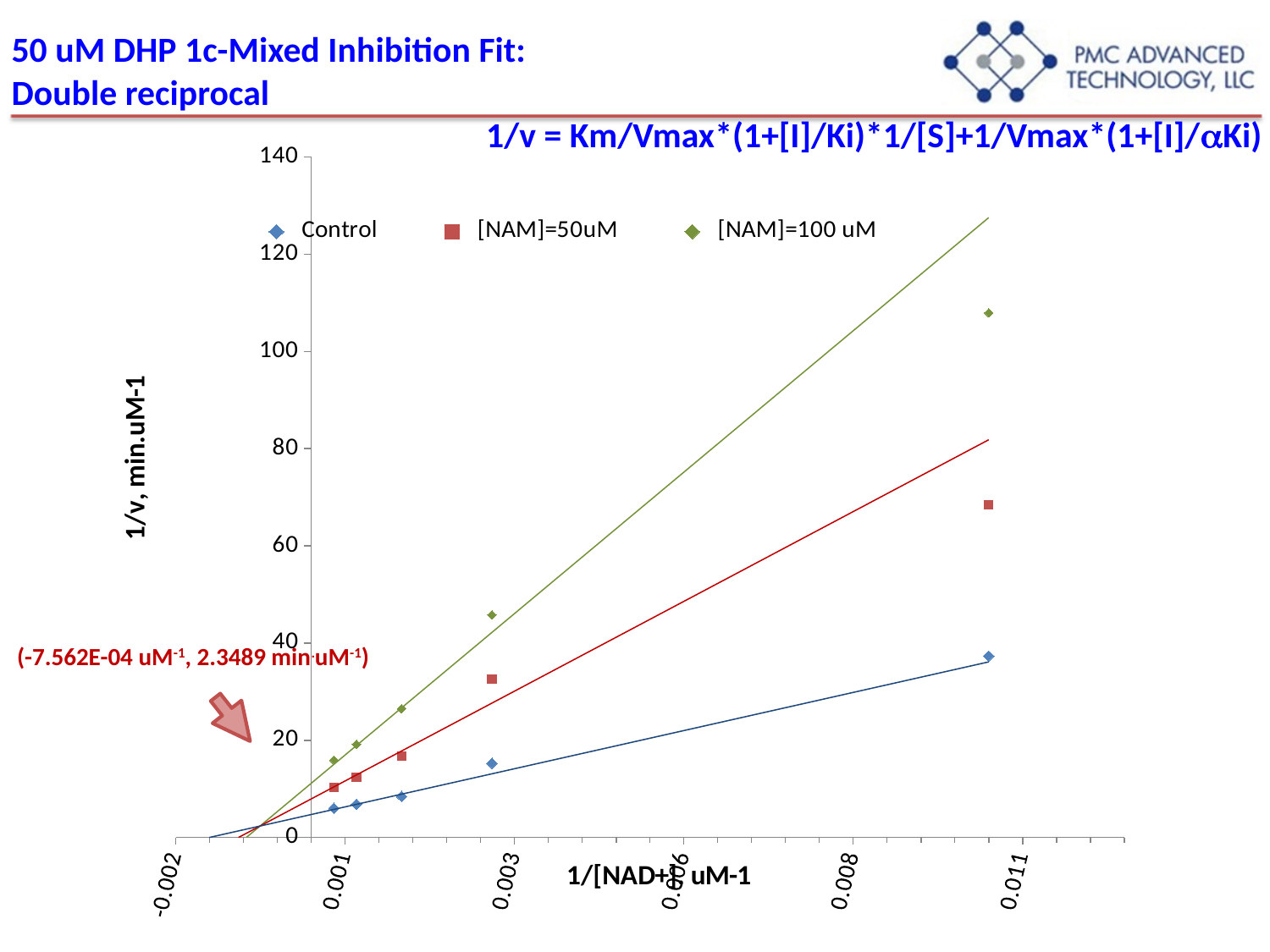
How many data points are plotted for the [NAM]=100 uM series? 5 At the largest 1/[NAD+] value plotted, which series has the lowest 1/v? Control What is the label on the chart's vertical axis? 1/v, min.uM-1 Is the highest [NAM]=100 uM data point greater or less than 100 on the 1/v axis? greater What kind of chart is shown on the slide? Scatter chart Is the highest Control data point greater or less than 60 on the 1/v axis? less Is the highest [NAM]=50uM data point greater or less than 80 on the 1/v axis? less What are the three series named in the chart's legend? Control, [NAM]=50uM, [NAM]=100 uM How many series does the chart's legend list? 3 Do the 1/v values for each series rise or fall as 1/[NAD+] increases? rise How many data points are plotted for the Control series? 5 At the largest 1/[NAD+] value plotted, which series has the highest 1/v? [NAM]=100 uM